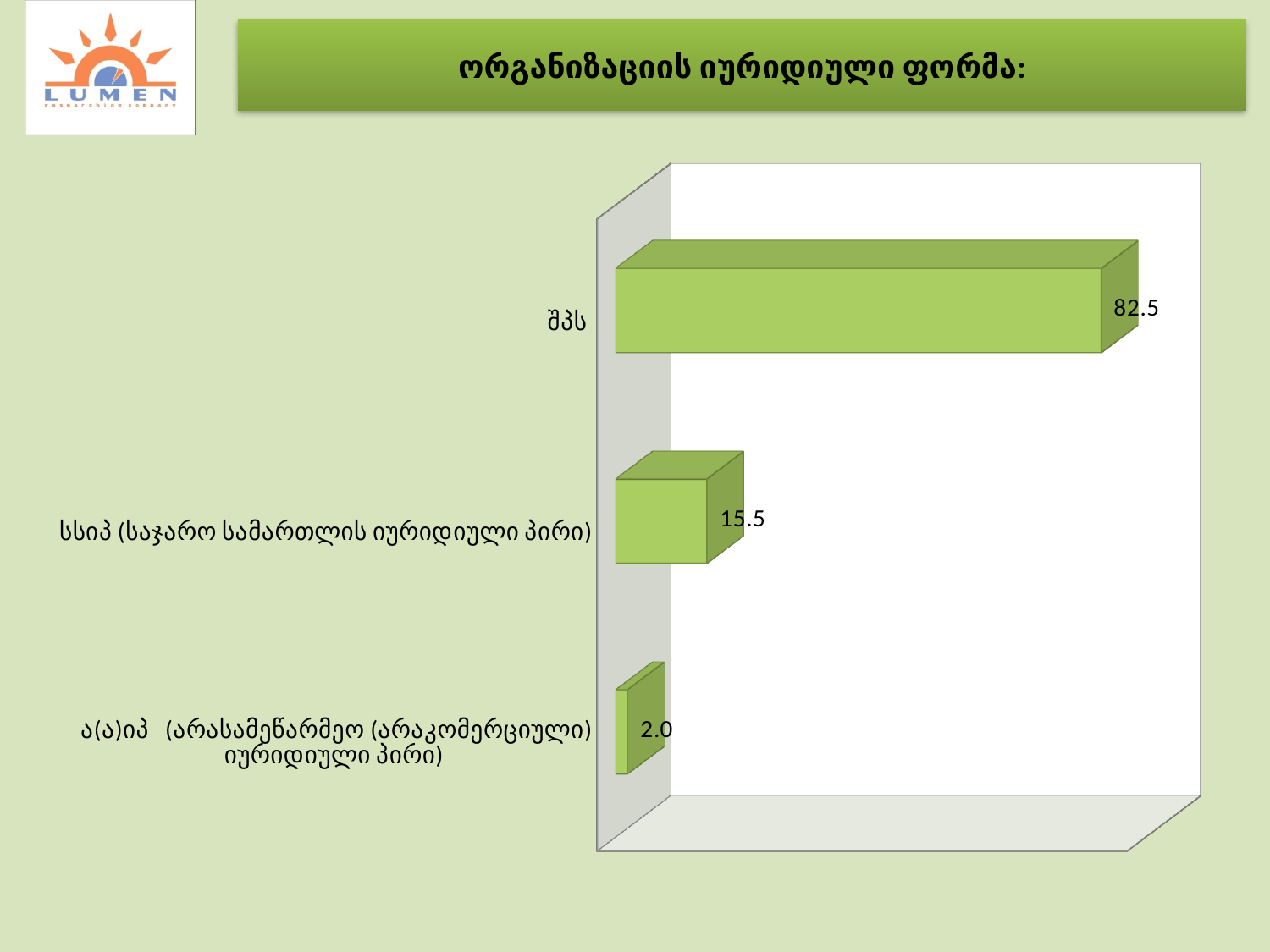
What is the title of the slide? ორგანიზაციის იურიდიული ფორმა: What is the value for შპს? 82.5 What is the difference between the values for სსიპ and ა(ა)იპ? 13.5 Which category has the lowest value? ა(ა)იპ (არასამეწარმეო (არაკომერციული) იურიდიული პირი) What is the value for სსიპ (საჯარო სამართლის იურიდიული პირი)? 15.5 What kind of chart is shown on the slide? bar chart What is the difference between the values for შპს and სსიპ? 67.0 How many categories are shown in the chart? 3 Which category has the highest value? შპს What is the value for ა(ა)იპ (არასამეწარმეო (არაკომერციული) იურიდიული პირი)? 2.0 Which is larger, the value for სსიპ or the value for ა(ა)იპ? სსიპ What colour are the bars in the chart? green